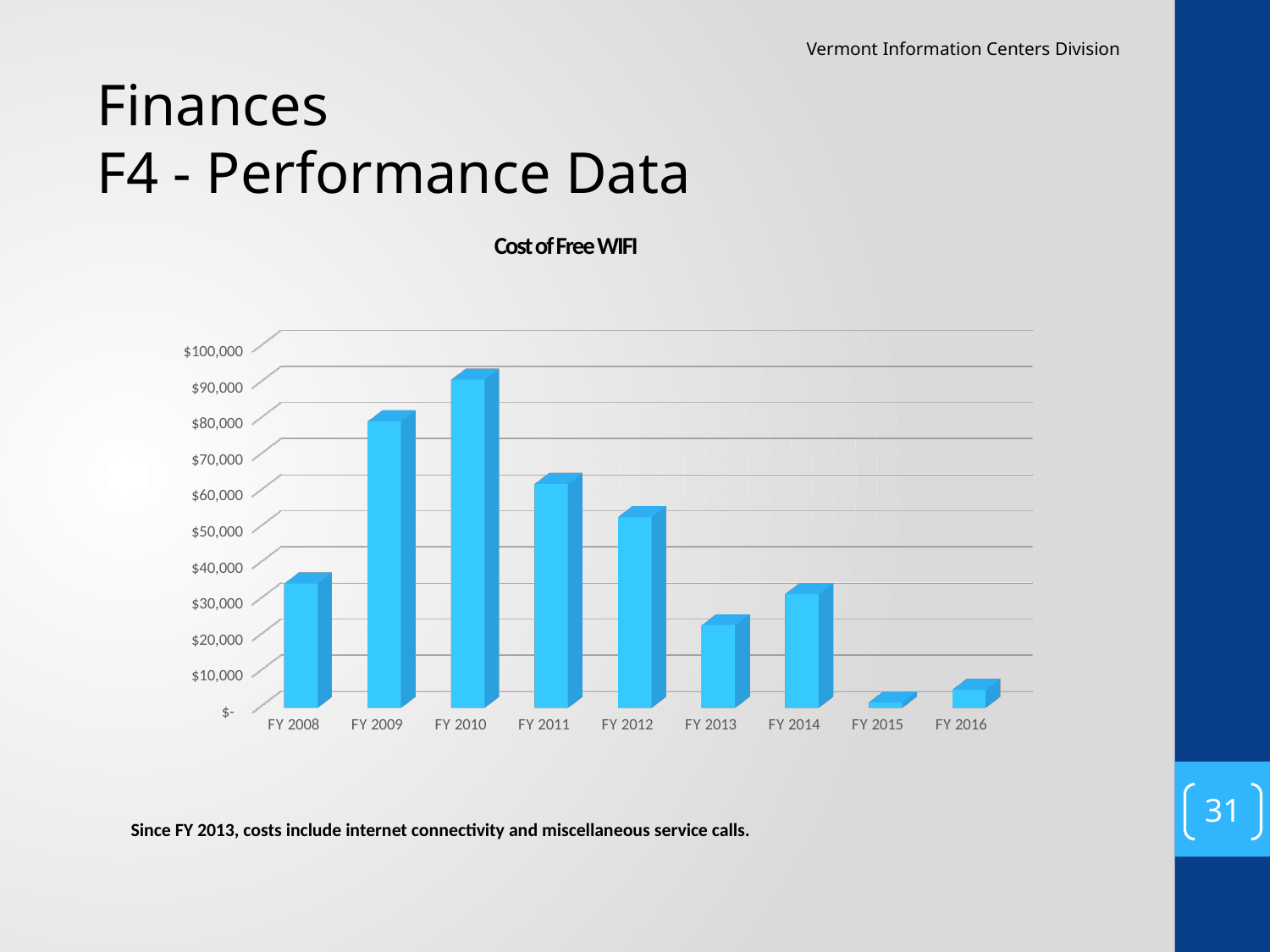
Which fiscal year has the lowest cost of free WIFI? FY 2015 Which is larger, the cost for FY 2009 or FY 2011? FY 2009 Is the value for FY 2010 greater or less than $80,000? greater Do the values rise or fall from FY 2010 to FY 2013? fall Is the value for FY 2013 greater or less than $30,000? less What is the title of the chart? Cost of Free WIFI Which fiscal year has the highest cost of free WIFI? FY 2010 Is the value for FY 2015 greater or less than $10,000? less What kind of chart is shown on the slide? Bar chart How many fiscal years are plotted on the chart? 9